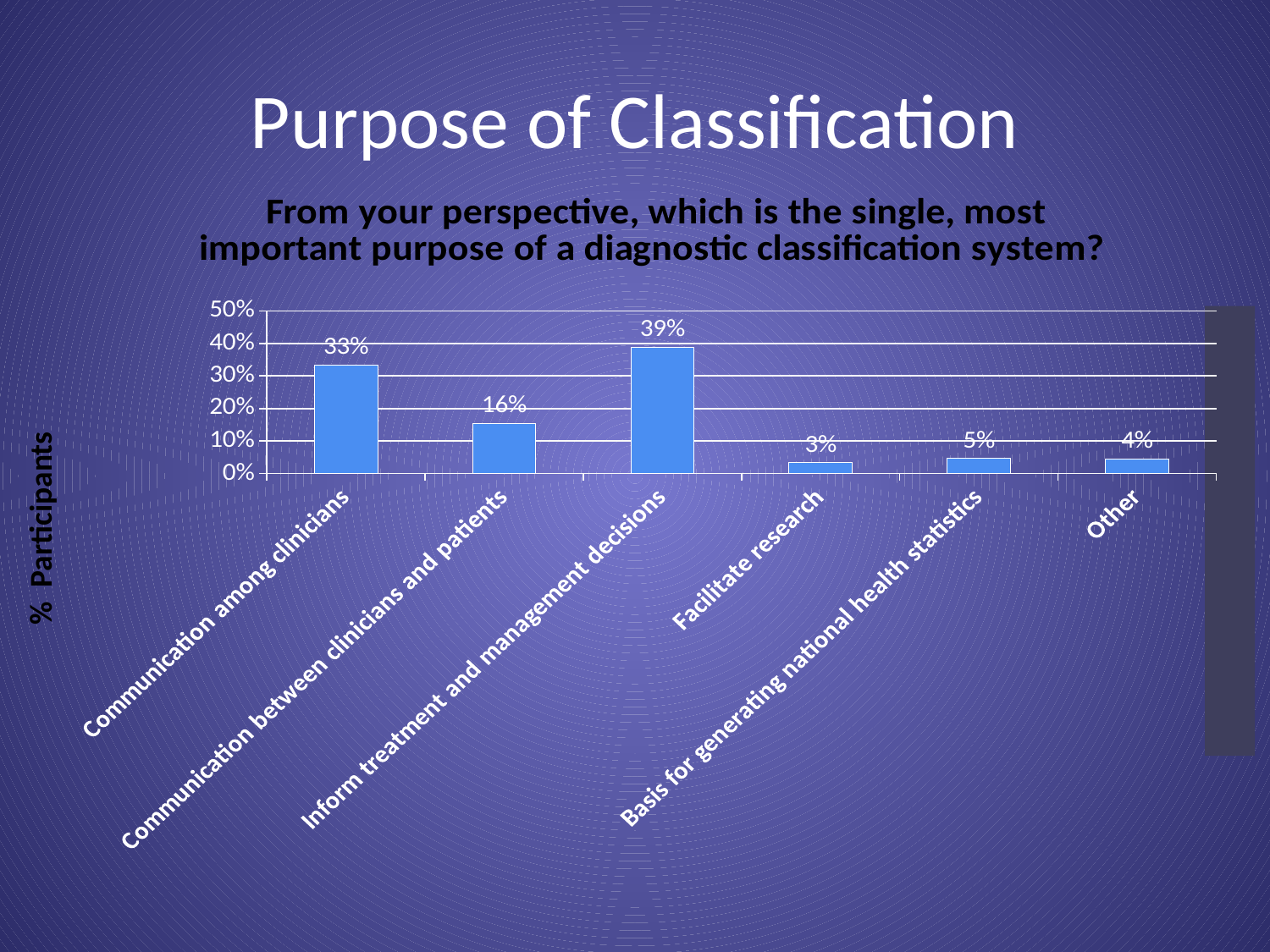
What kind of chart is shown on the slide? Bar chart Which category has the lowest value? Facilitate research What percentage of participants chose 'Inform treatment and management decisions'? 39% Is the value for 'Communication between clinicians and patients' greater or less than 20%? less What is the value for 'Other'? 4% How many categories are shown on the x axis? 6 What percentage of participants chose 'Facilitate research'? 3% What is the label of the vertical axis? % Participants Which is larger: 'Communication between clinicians and patients' or 'Basis for generating national health statistics'? Communication between clinicians and patients What is the difference between 'Inform treatment and management decisions' and 'Communication among clinicians'? 6% What is the value for 'Communication among clinicians'? 33% Which category has the highest value? Inform treatment and management decisions